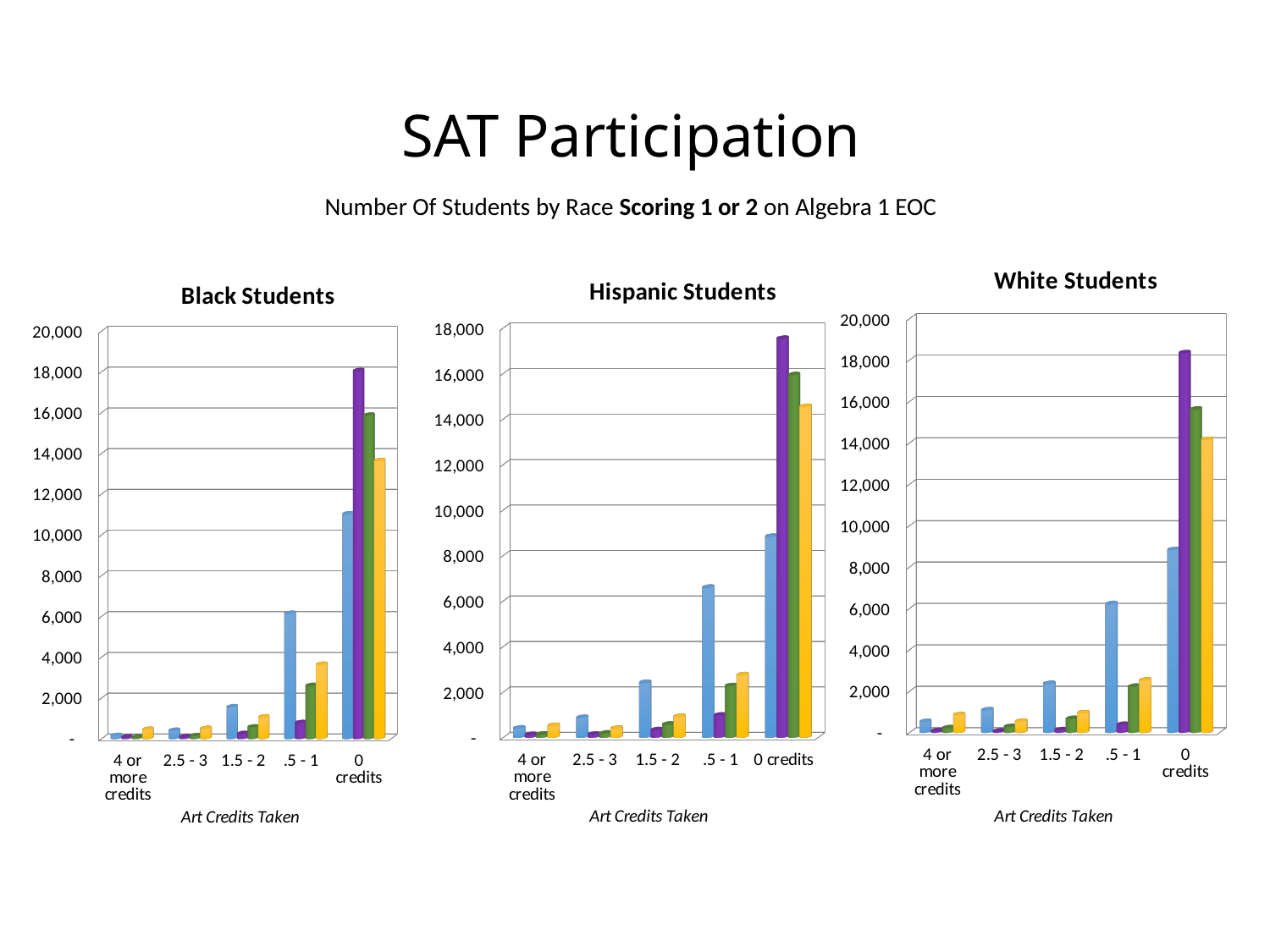
In the White Students chart, which art-credit category has the shortest bars? 4 or more credits How many art-credit categories are shown on the x axis of the Hispanic Students chart? 5 How many charts are shown on the slide? 3 In the White Students chart, is the value of the blue bar for .5 - 1 credits greater or less than 4,000? greater What is the x-axis title of the Hispanic Students chart? Art Credits Taken In the Hispanic Students chart, is the value of the purple bar for 0 credits greater or less than 16,000? greater In the Black Students chart, which art-credit category has the tallest bars? 0 credits In the Hispanic Students chart, is the value of the blue bar for .5 - 1 credits greater or less than 6,000? greater In the White Students chart, do the bar values generally rise or fall moving from 4 or more credits to 0 credits along the x axis? rise In the Black Students chart, which is larger: the blue bar for 0 credits or the blue bar for .5 - 1 credits? 0 credits What kind of chart is the Black Students chart? bar chart